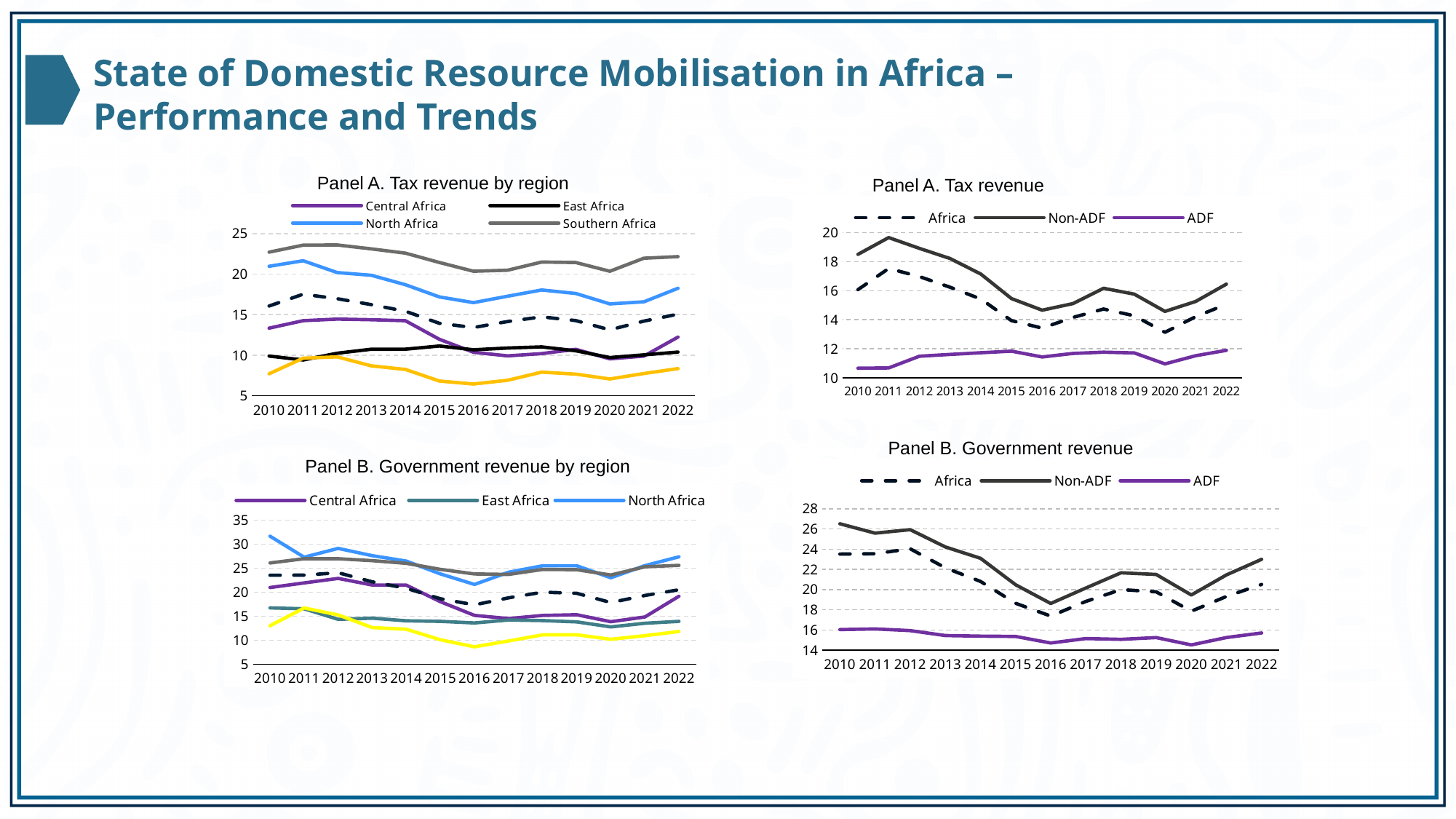
In 'Panel B. Government revenue by region' (bottom left), is the North Africa value for 2010 greater or less than 30? greater In 'Panel B. Government revenue' (bottom right), which is larger in 2012, Non-ADF or ADF? Non-ADF In 'Panel B. Government revenue' (bottom right), is the ADF value for 2020 greater or less than 16? less In 'Panel A. Tax revenue' (top right), does the Non-ADF series rise or fall from 2011 to 2016? fall How many years are plotted on the x axis of 'Panel A. Tax revenue by region' (top left)? 13 In 'Panel A. Tax revenue' (top right), which series has the highest values across the period? Non-ADF In 'Panel B. Government revenue' (bottom right), is the Non-ADF value for 2016 greater or less than 20? less In 'Panel A. Tax revenue' (top right), which series has the lowest values across the period? ADF What kind of chart is 'Panel A. Tax revenue' (top right)? Line chart In 'Panel A. Tax revenue' (top right), how many series does the legend list? 3 How many charts are shown on the slide? 4